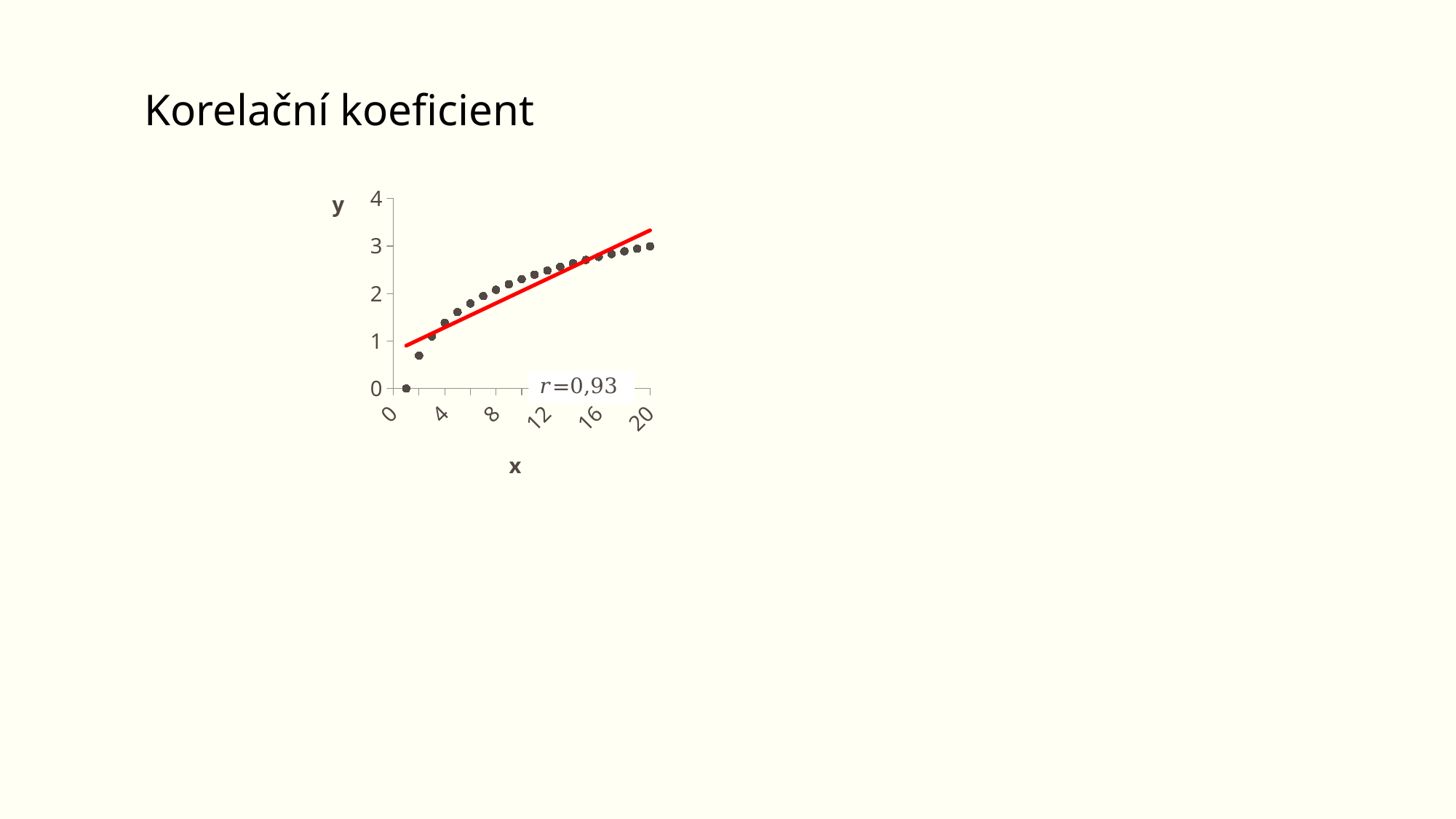
At which x value is the plotted y value highest? 20 Is the y value of the point at x = 4 greater or less than 2? less Which point has the larger y value, the one at x = 4 or the one at x = 16? x = 16 At which x value is the plotted y value lowest? 1 How many data points are plotted on the chart? 20 What kind of chart is shown on the slide? scatter chart Is the y value of the point at x = 20 greater or less than 2? greater What is the y value of the point at x = 1? 0 What colour is the trend line drawn through the points? red What is the correlation coefficient r shown on the chart? 0,93 Is the y value of the point at x = 12 greater or less than 2? greater Do the plotted y values rise or fall as x increases? rise